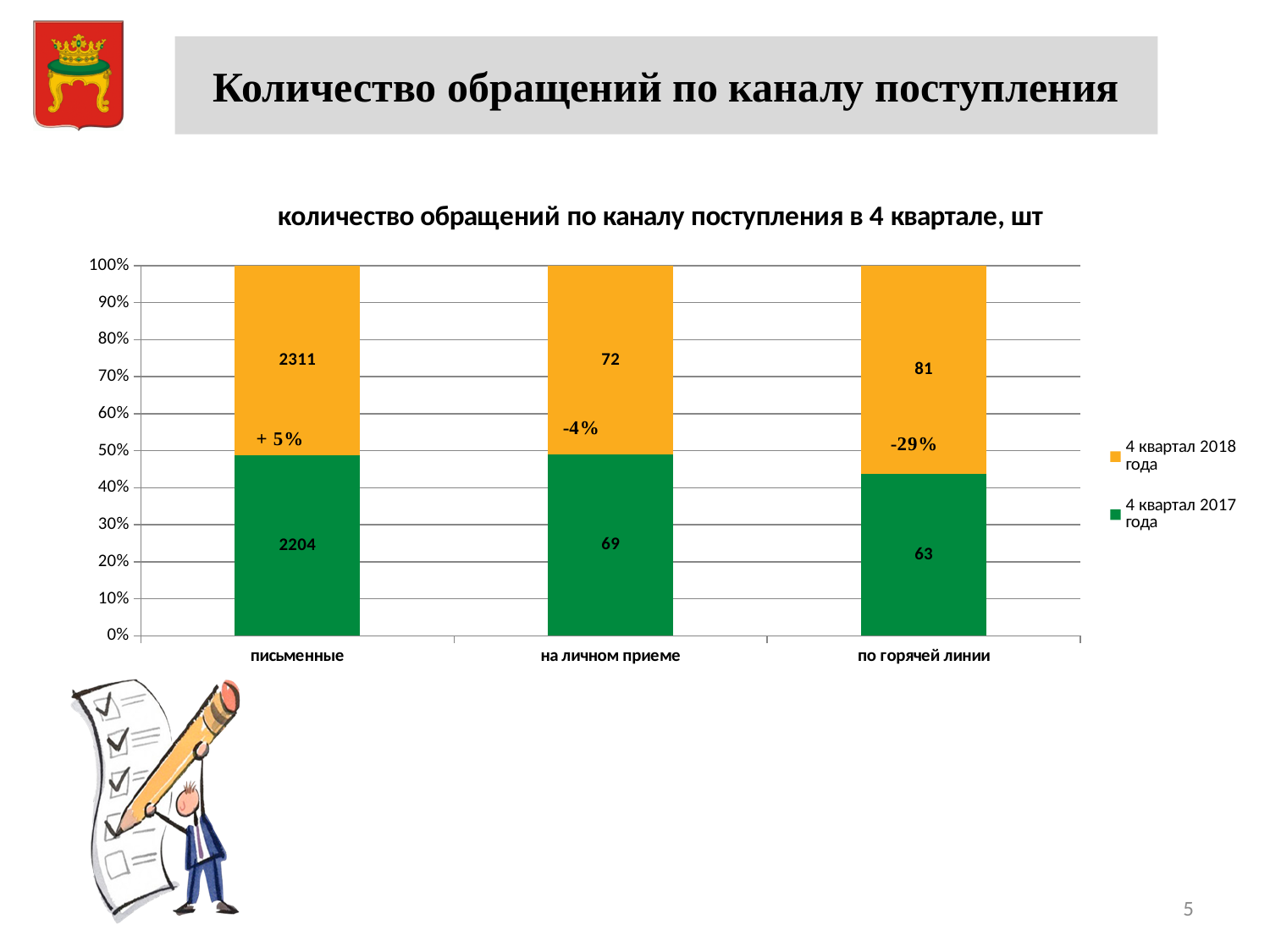
What is the value for 'по горячей линии' in the '4 квартал 2017 года' series? 63 What is the difference between the '4 квартал 2018 года' and '4 квартал 2017 года' values for 'по горячей линии'? 18 What is the value for 'на личном приеме' in the '4 квартал 2018 года' series? 72 What is the value for 'письменные' in the '4 квартал 2018 года' series? 2311 Which category has the lowest value in the '4 квартал 2017 года' series? по горячей линии What is the title of the chart? количество обращений по каналу поступления в 4 квартале, шт Which category has the highest value in the '4 квартал 2018 года' series? письменные How many series does the legend list? 2 What is the value for 'письменные' in the '4 квартал 2017 года' series? 2204 Which is larger for 'на личном приеме': the '4 квартал 2018 года' value or the '4 квартал 2017 года' value? 4 квартал 2018 года How many categories are shown on the x axis? 3 What kind of chart is shown on the slide? stacked bar chart